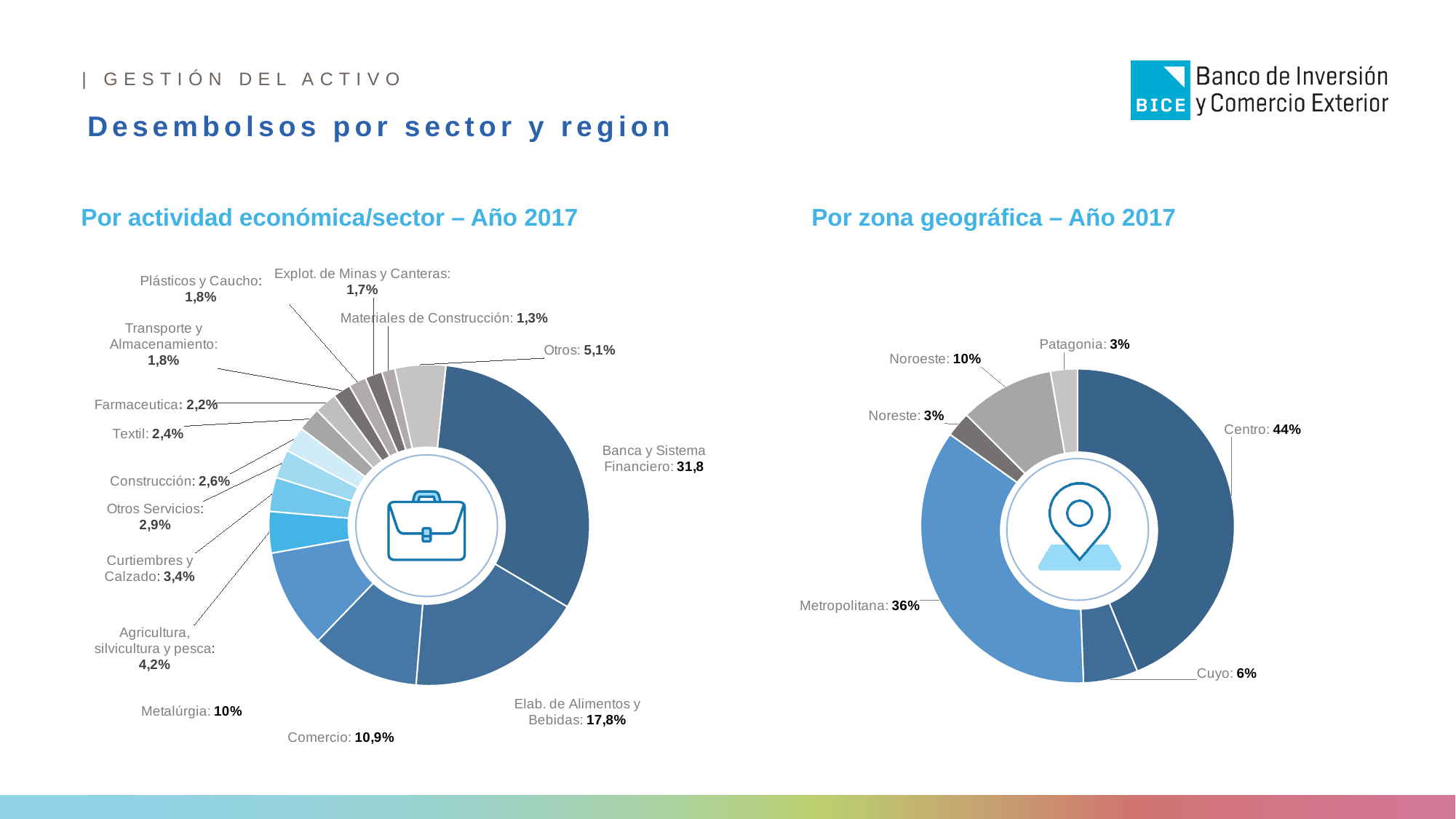
In the 'Por actividad económica/sector – Año 2017' chart, which sector has the smallest share? Materiales de Construcción In the 'Por zona geográfica – Año 2017' chart, how many regions are shown? 6 In the 'Por actividad económica/sector – Año 2017' chart, what is the value for Comercio? 10,9% In the 'Por zona geográfica – Año 2017' chart, what is the difference between Centro and Metropolitana? 8% In the 'Por zona geográfica – Año 2017' chart, which is larger, Cuyo or Noreste? Cuyo In the 'Por actividad económica/sector – Año 2017' chart, how many sectors are shown? 15 In the 'Por actividad económica/sector – Año 2017' chart, what is the value for Elab. de Alimentos y Bebidas? 17,8% In the 'Por zona geográfica – Año 2017' chart, what is the value for Noroeste? 10% In the 'Por actividad económica/sector – Año 2017' chart, which sector has the largest share? Banca y Sistema Financiero What kind of chart is used for 'Por zona geográfica – Año 2017'? Pie (donut) chart In the 'Por zona geográfica – Año 2017' chart, which region has the largest share? Centro In the 'Por zona geográfica – Año 2017' chart, what is the value for Centro? 44%